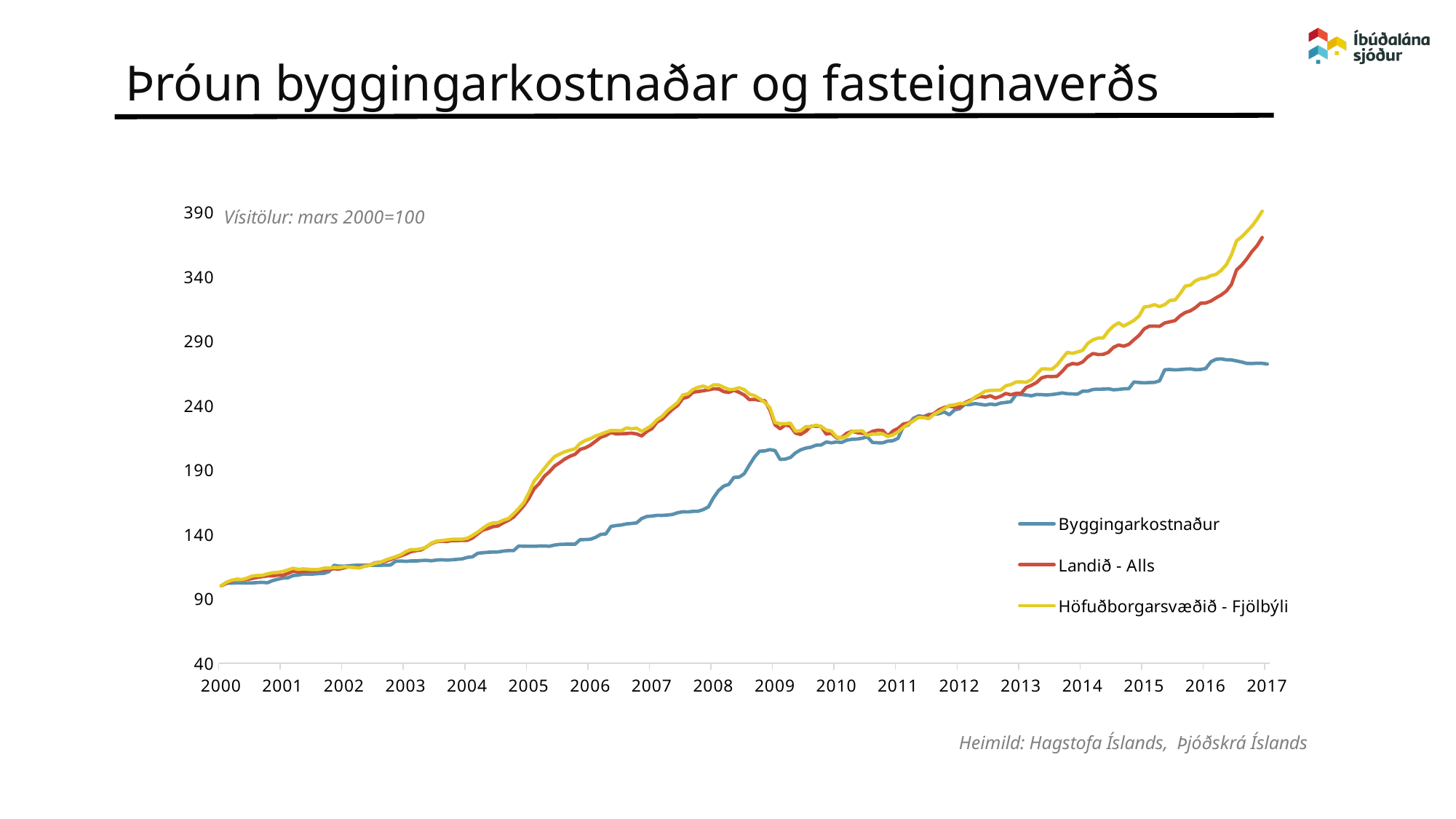
Which series has the highest value at 2017? Höfuðborgarsvæðið - Fjölbýli Is the value for Byggingarkostnaður at 2008 greater or less than 190? less At 2008, which is higher: Landið - Alls or Byggingarkostnaður? Landið - Alls Is the value for Byggingarkostnaður at 2017 greater or less than 290? less Does the Byggingarkostnaður series rise or fall overall from 2000 to 2017? rise What kind of chart is shown on the slide? line chart Is the value for Landið - Alls at 2005 greater or less than 140? greater Which series has the lowest value at 2017? Byggingarkostnaður How many series does the legend list? 3 Does the Landið - Alls series rise or fall between 2008 and 2010? fall What is the title of the slide? Þróun byggingarkostnaðar og fasteignaverðs